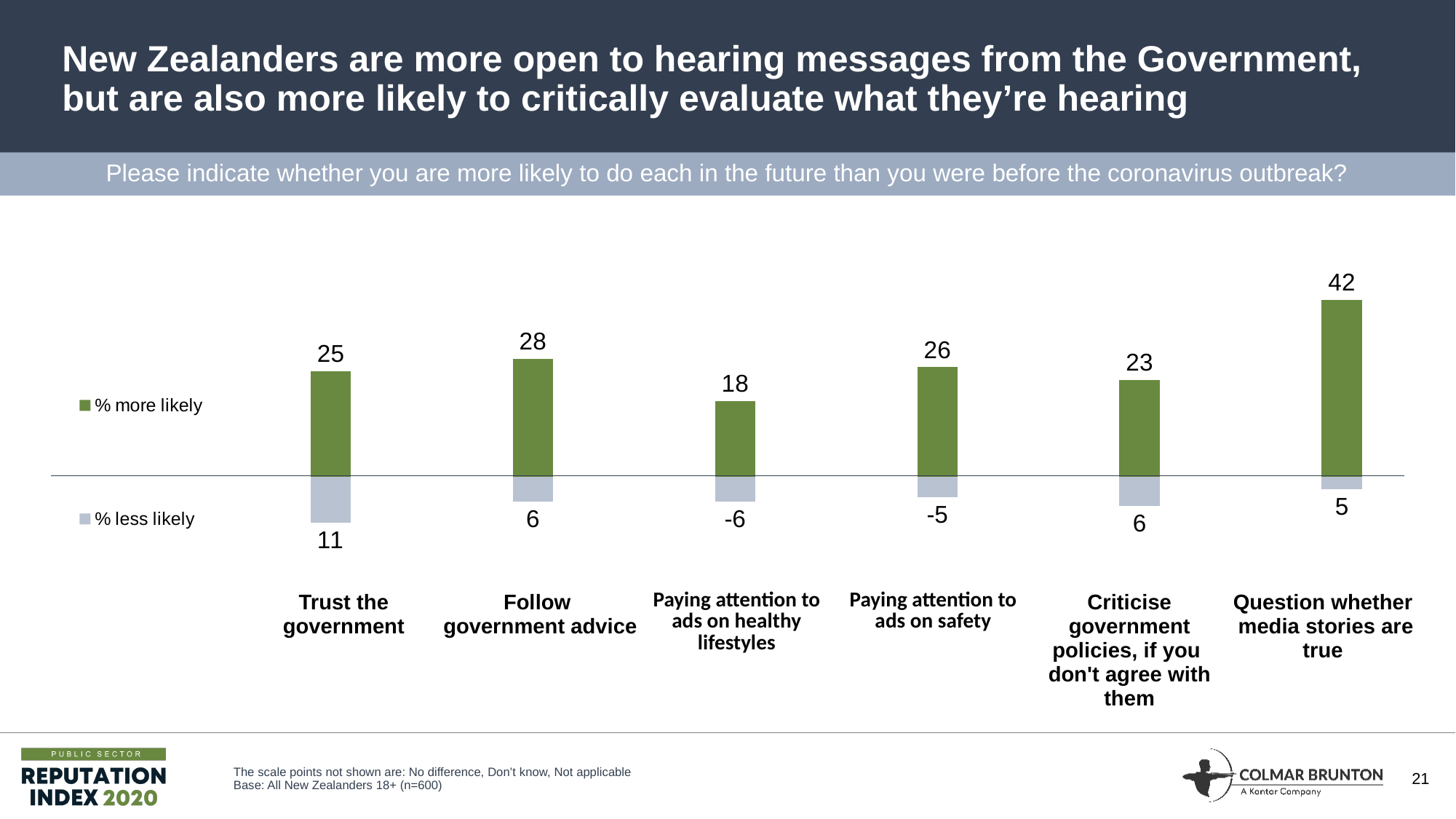
Which has a larger % more likely value: 'Trust the government' or 'Paying attention to ads on safety'? Paying attention to ads on safety Which category has the lowest % more likely value? Paying attention to ads on healthy lifestyles How many series does the legend list? 2 What is the % more likely value for 'Question whether media stories are true'? 42 What is the % more likely value for 'Paying attention to ads on healthy lifestyles'? 18 What is the % more likely value for 'Criticise government policies, if you don't agree with them'? 23 How many categories are shown on the chart? 6 What is the % less likely value shown for 'Trust the government'? 11 What is the difference between the % more likely values for 'Question whether media stories are true' and 'Follow government advice'? 14 What kind of chart is shown on the slide? Bar chart Which category has the highest % more likely value? Question whether media stories are true Which colour represents the '% more likely' series? Green